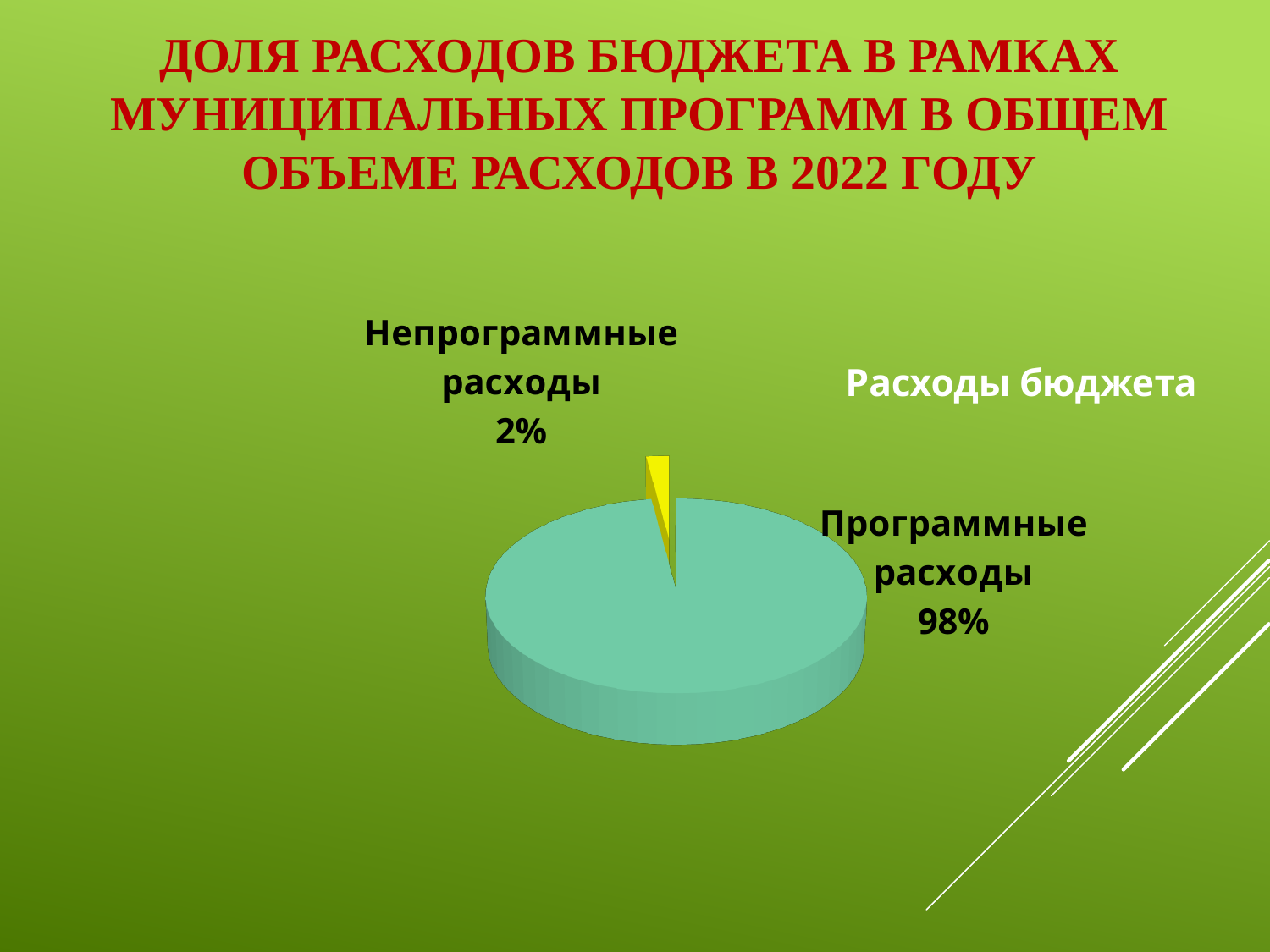
Which slice of the pie is the smallest? Непрограммные расходы Which slice of the pie is the largest? Программные расходы What is the difference in percentage points between Программные расходы and Непрограммные расходы? 96 What colour is the Непрограммные расходы slice? yellow What is the title of the pie chart? Расходы бюджета What share of the pie does Непрограммные расходы represent? 2% What kind of chart is shown on the slide? pie chart How many slices does the pie chart have? 2 What share of the pie does Программные расходы represent? 98% Which is larger, Программные расходы or Непрограммные расходы? Программные расходы